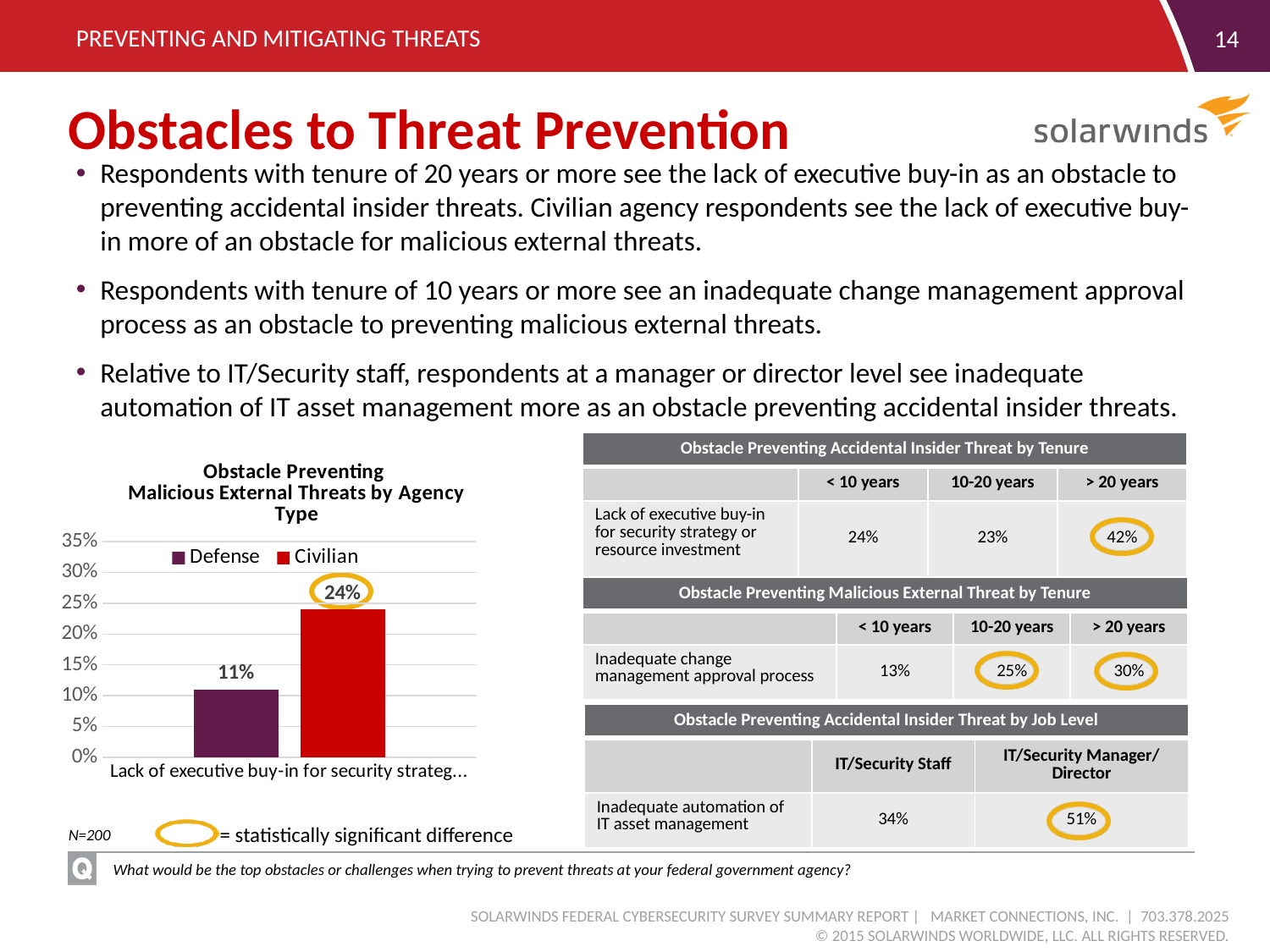
In the chart 'Obstacle Preventing Malicious External Threats by Agency Type', which series is shown in red? Civilian In the chart 'Obstacle Preventing Malicious External Threats by Agency Type', what is the difference between the Civilian and Defense values? 13% In the chart 'Obstacle Preventing Malicious External Threats by Agency Type', is the value for Civilian greater or less than 20%? greater In the chart 'Obstacle Preventing Malicious External Threats by Agency Type', is the value for Defense greater or less than 15%? less In the chart 'Obstacle Preventing Malicious External Threats by Agency Type', what is the value for Civilian? 24% What is the highest value shown on the y axis of the chart 'Obstacle Preventing Malicious External Threats by Agency Type'? 35% How many series does the legend of the chart 'Obstacle Preventing Malicious External Threats by Agency Type' list? 2 In the chart 'Obstacle Preventing Malicious External Threats by Agency Type', which value is circled as a statistically significant difference? 24% What kind of chart is 'Obstacle Preventing Malicious External Threats by Agency Type'? Bar chart In the chart 'Obstacle Preventing Malicious External Threats by Agency Type', what is the value for Defense? 11% In the chart 'Obstacle Preventing Malicious External Threats by Agency Type', which series has the lowest value? Defense In the chart 'Obstacle Preventing Malicious External Threats by Agency Type', which series has the higher value, Defense or Civilian? Civilian